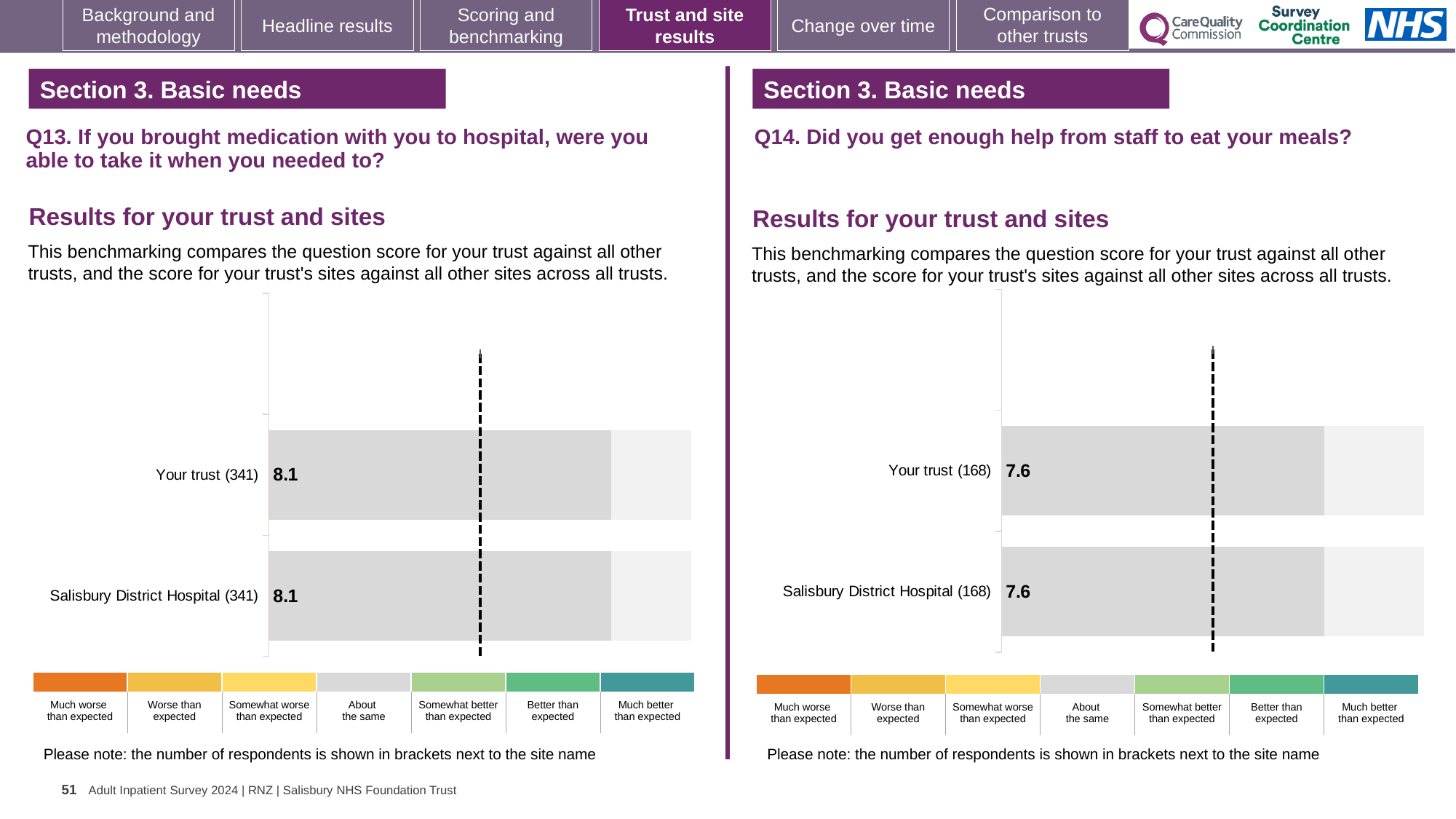
Is the score for Your trust on the Q13 chart (left) larger or smaller than the score for Your trust on the Q14 chart (right)? Larger On the Q13 chart (left), how many respondents are shown in brackets next to Your trust? 341 What kind of chart is shown for Q13 (left)? Bar chart On the Q14 chart (right), what is the score for Salisbury District Hospital? 7.6 On the Q13 chart (left), what is the difference between the score for Your trust and the score for Salisbury District Hospital? 0 On the Q13 chart (left), what is the score for Salisbury District Hospital? 8.1 How many bars are plotted on the Q14 chart (right)? 2 On the Q14 chart (right), what is the score for Your trust? 7.6 On the Q13 chart (left), what is the score for Your trust? 8.1 On the Q14 chart (right), how many respondents are shown in brackets next to Salisbury District Hospital? 168 How many bars are plotted on the Q13 chart (left)? 2 On the Q14 chart (right), what is the difference between the score for Your trust and the score for Salisbury District Hospital? 0